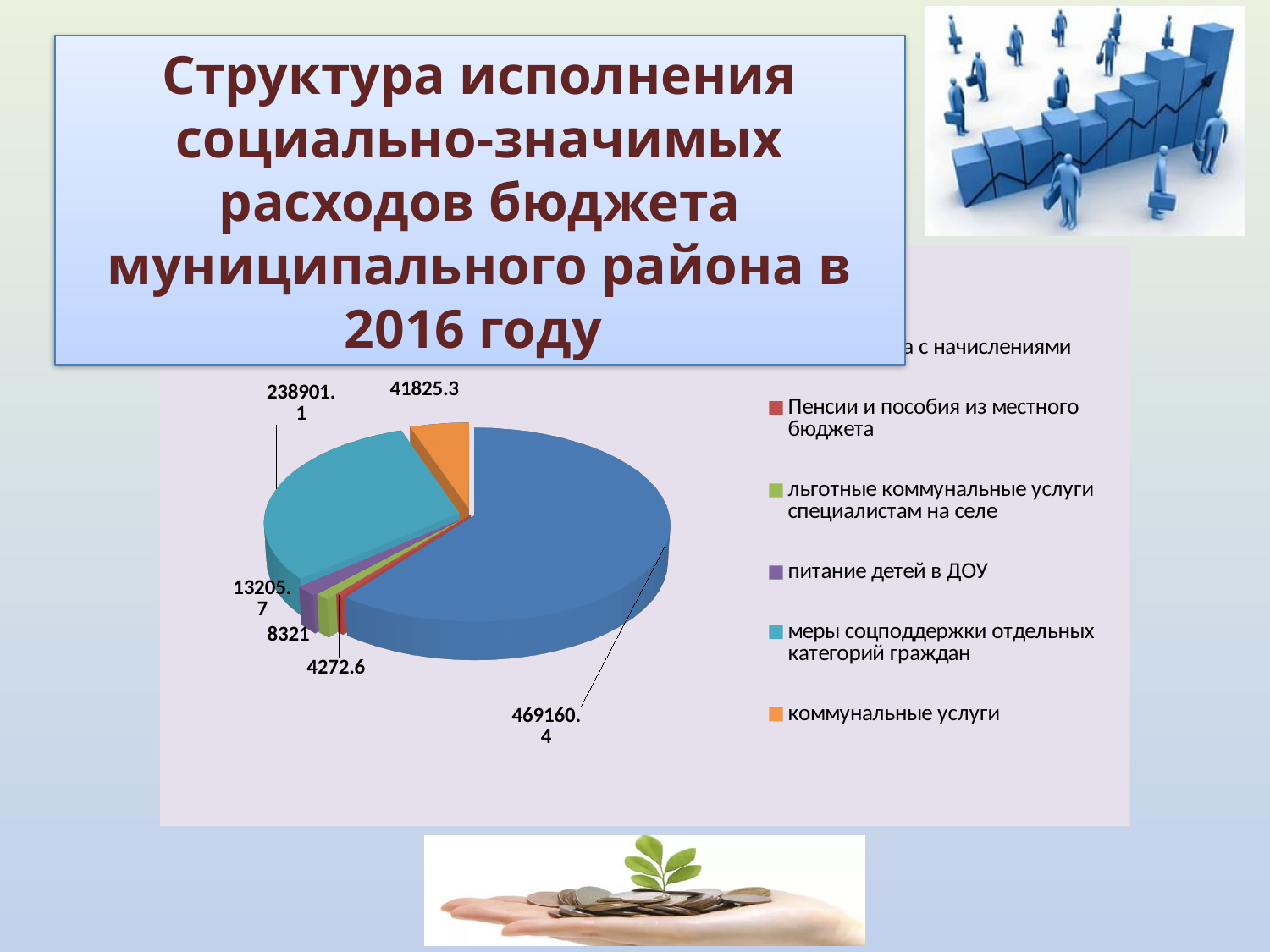
Which legend category has the smallest slice in the pie chart? Пенсии и пособия из местного бюджета What kind of chart is shown on the slide? Pie chart How many slices does the pie chart have? 6 What is the largest value labelled on the pie chart? 469160.4 What value is shown for the slice 'льготные коммунальные услуги специалистам на селе'? 8321 What value is shown for the slice 'питание детей в ДОУ'? 13205.7 What value is shown for the slice 'коммунальные услуги'? 41825.3 What value is shown for the slice 'меры соцподдержки отдельных категорий граждан'? 238901.1 What is the difference between the value for 'меры соцподдержки отдельных категорий граждан' and the value for 'коммунальные услуги'? 197075.8 Which is larger: the value for 'коммунальные услуги' or the value for 'питание детей в ДОУ'? коммунальные услуги What value is shown for the slice 'Пенсии и пособия из местного бюджета'? 4272.6 How many entries does the legend list? 6